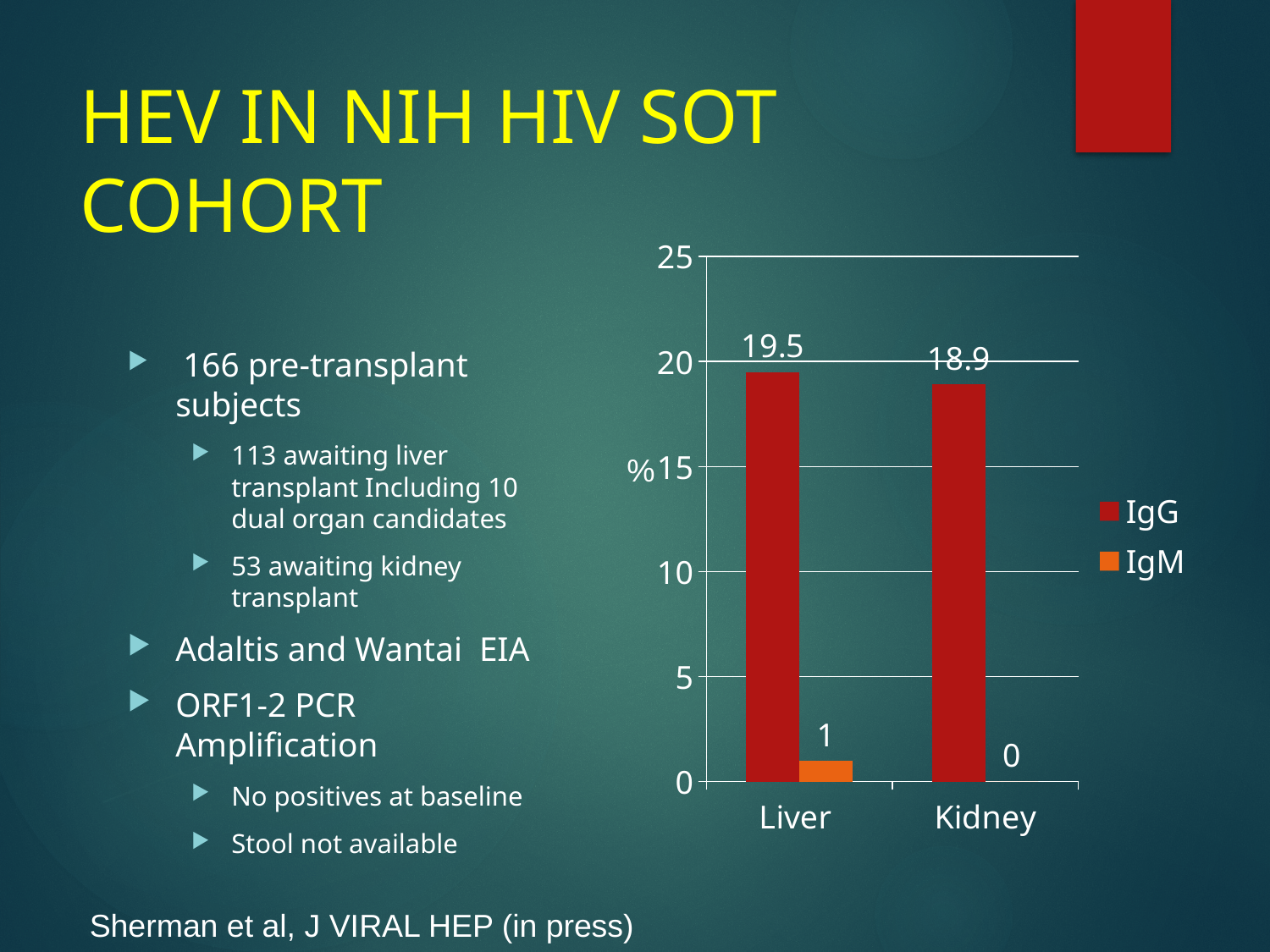
What is the IgG value for Liver? 19.5 How many series does the legend list? 2 What is the IgG value for Kidney? 18.9 How many categories are shown on the x axis? 2 What is the difference between the IgG values for Liver and Kidney? 0.6 Which category has the higher IgG value? Liver Which category has the lower IgM value? Kidney What is the IgM value for Kidney? 0 What is the IgM value for Liver? 1 What kind of chart is shown on the slide? bar chart Is the IgG value for Liver greater or less than 15? greater What label is shown on the y axis? %